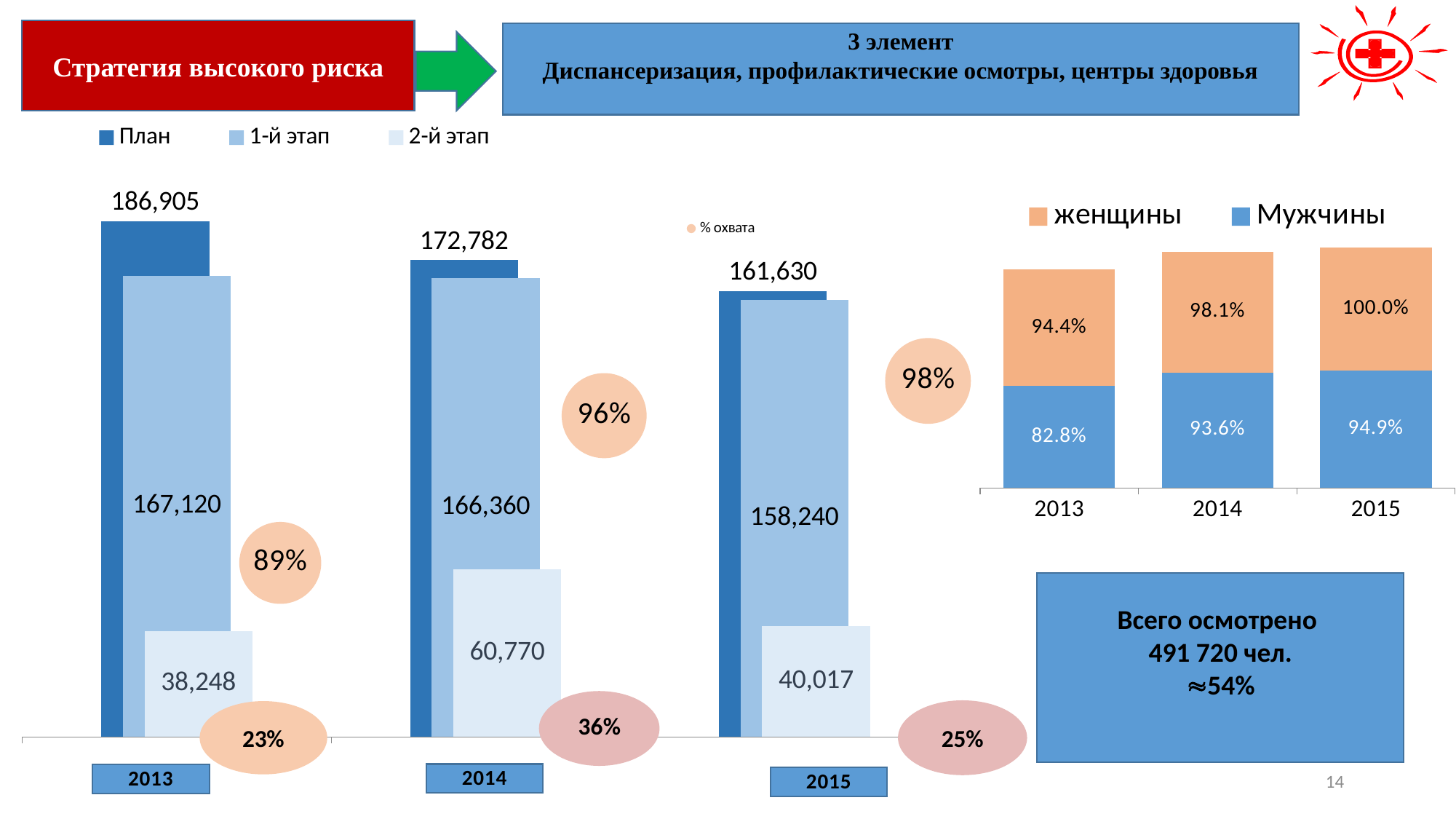
In the left bar chart, which year has the highest План value? 2013 In the left bar chart, what is the difference between План and 1-й этап for 2013? 19,785 In the right stacked chart (женщины / Мужчины), do the Мужчины values rise or fall from 2013 to 2015? rise How many series does the legend of the left bar chart list? 3 In the left bar chart, what is the value of 2-й этап for 2014? 60,770 In the right stacked chart (женщины / Мужчины), what is the value for Мужчины in 2013? 82.8% In the left bar chart, what is the value of План for 2013? 186,905 In the left bar chart, which year has the lowest 2-й этап value? 2013 How many years are shown on the x axis of the left bar chart? 3 In the right stacked chart (женщины / Мужчины), which year has the highest value for женщины? 2015 What kind of chart is the right chart with женщины and Мужчины? stacked bar chart In the left bar chart, is the 1-й этап value larger for 2014 or for 2015? 2014